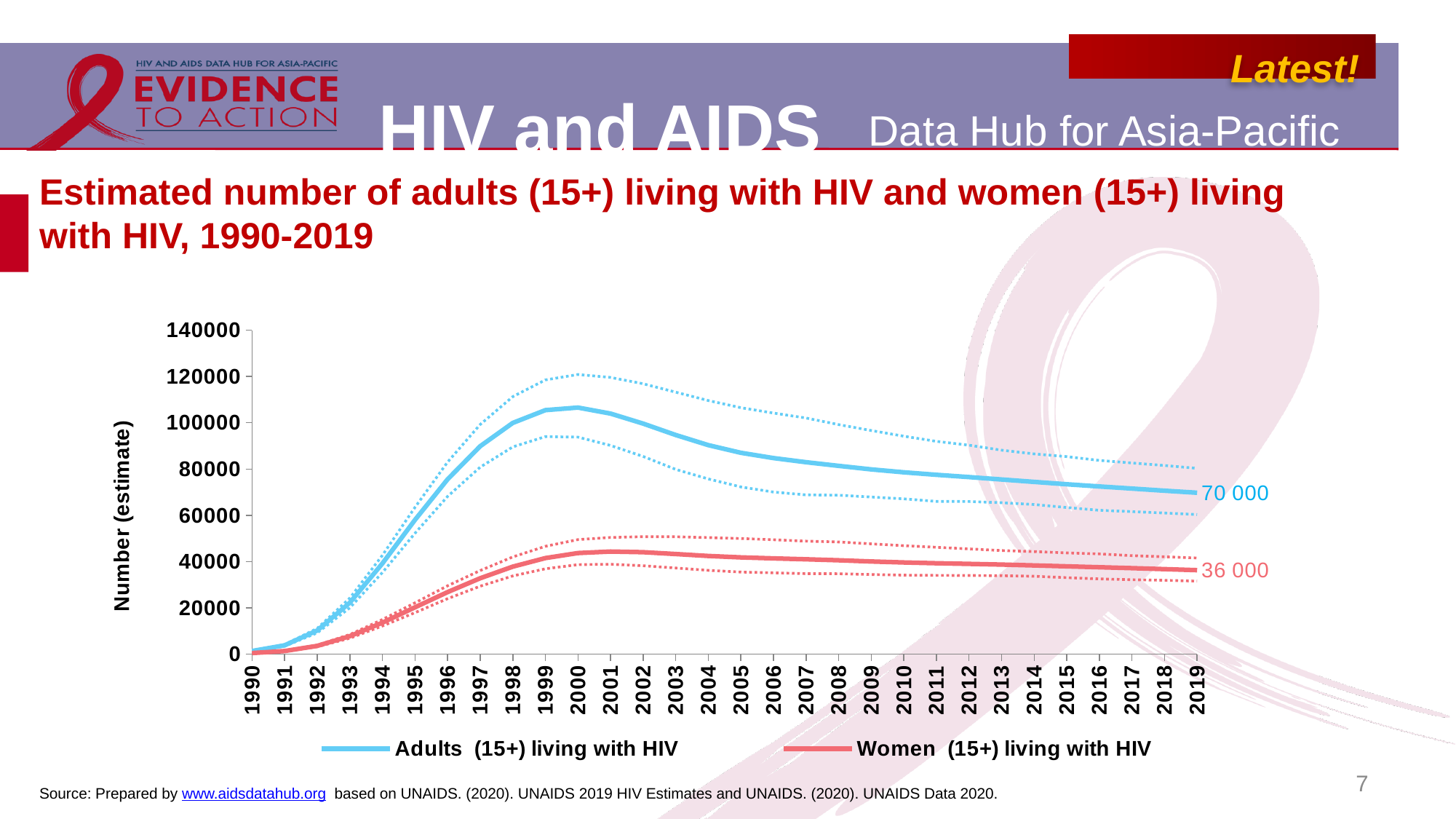
Does the Adults (15+) living with HIV line rise or fall between 2000 and 2019? fall What is the title of the y axis? Number (estimate) In 2019, which series has the larger value: Adults (15+) living with HIV or Women (15+) living with HIV? Adults (15+) living with HIV What is the difference between the 2019 values for Adults (15+) living with HIV and Women (15+) living with HIV? 34 000 Is the value for Women (15+) living with HIV in 2000 greater or less than 60000? less How many years are shown on the x axis? 30 What kind of chart is shown on the slide? line chart Is the value for Adults (15+) living with HIV in 1990 greater or less than 20000? less What is the labelled value for Women (15+) living with HIV in 2019? 36 000 Is the value for Adults (15+) living with HIV in 2000 greater or less than 100000? greater What is the labelled value for Adults (15+) living with HIV in 2019? 70 000 How many series does the legend list? 2